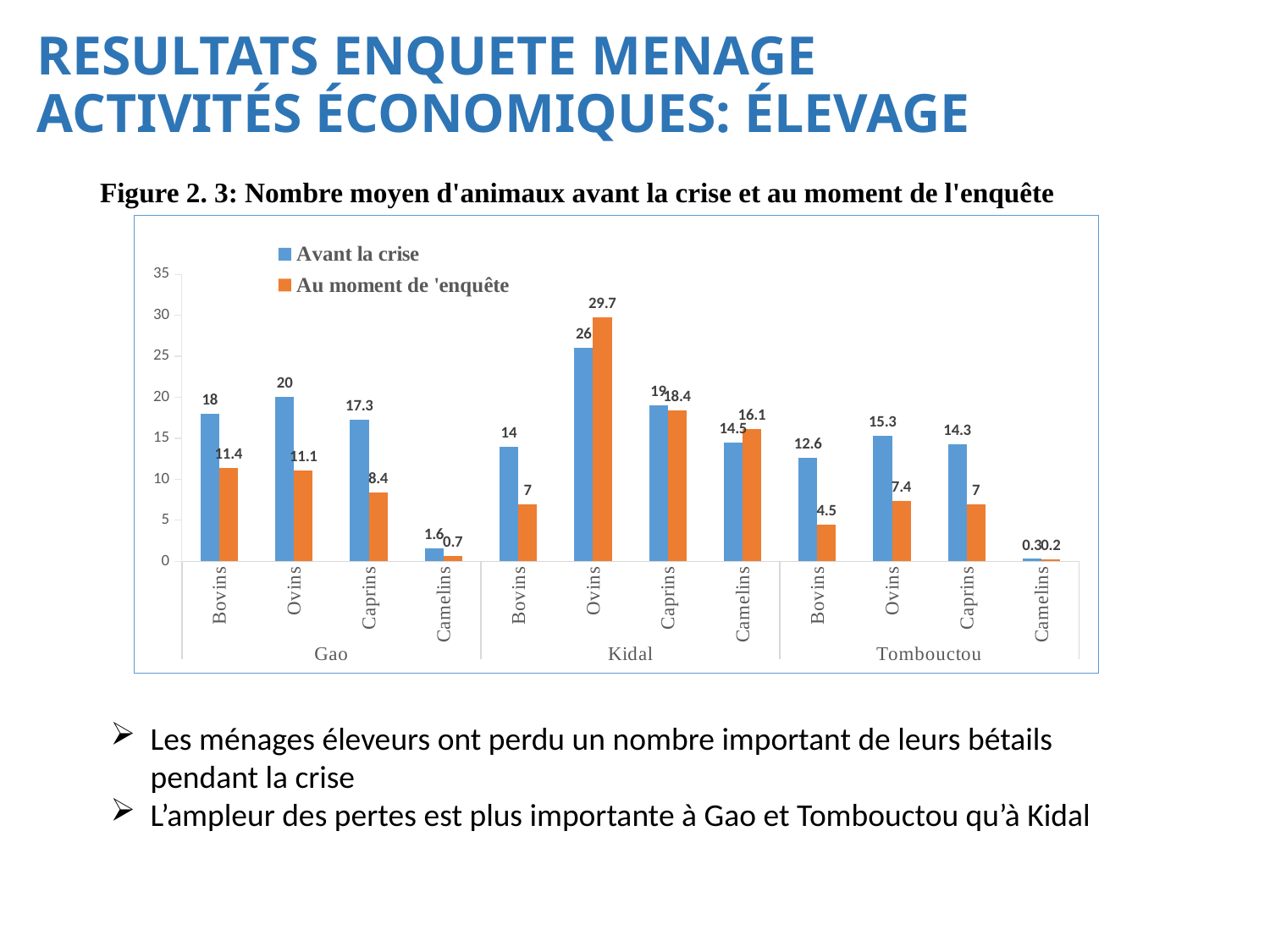
How many series does the legend list? 2 Which category has the highest value for the series 'Avant la crise'? Ovins (Kidal) What is the difference between the 'Avant la crise' and 'Au moment de 'enquête' values for Ovins in Gao? 8.9 What is the title of the figure? Figure 2. 3: Nombre moyen d'animaux avant la crise et au moment de l'enquête Which category has the lowest value for the series 'Au moment de 'enquête'? Camelins (Tombouctou) How many regions are shown along the x axis? 3 What is the value for Bovins in Gao for the series 'Avant la crise'? 18 Is the 'Avant la crise' value for Ovins in Kidal greater or less than 25? greater What is the value for Caprins in Tombouctou for the series 'Au moment de 'enquête'? 7 For Camelins in Kidal, which series has the larger value: 'Avant la crise' or 'Au moment de 'enquête'? Au moment de 'enquête What type of chart is shown on the slide? bar chart What is the value for Ovins in Kidal for the series 'Au moment de 'enquête'? 29.7